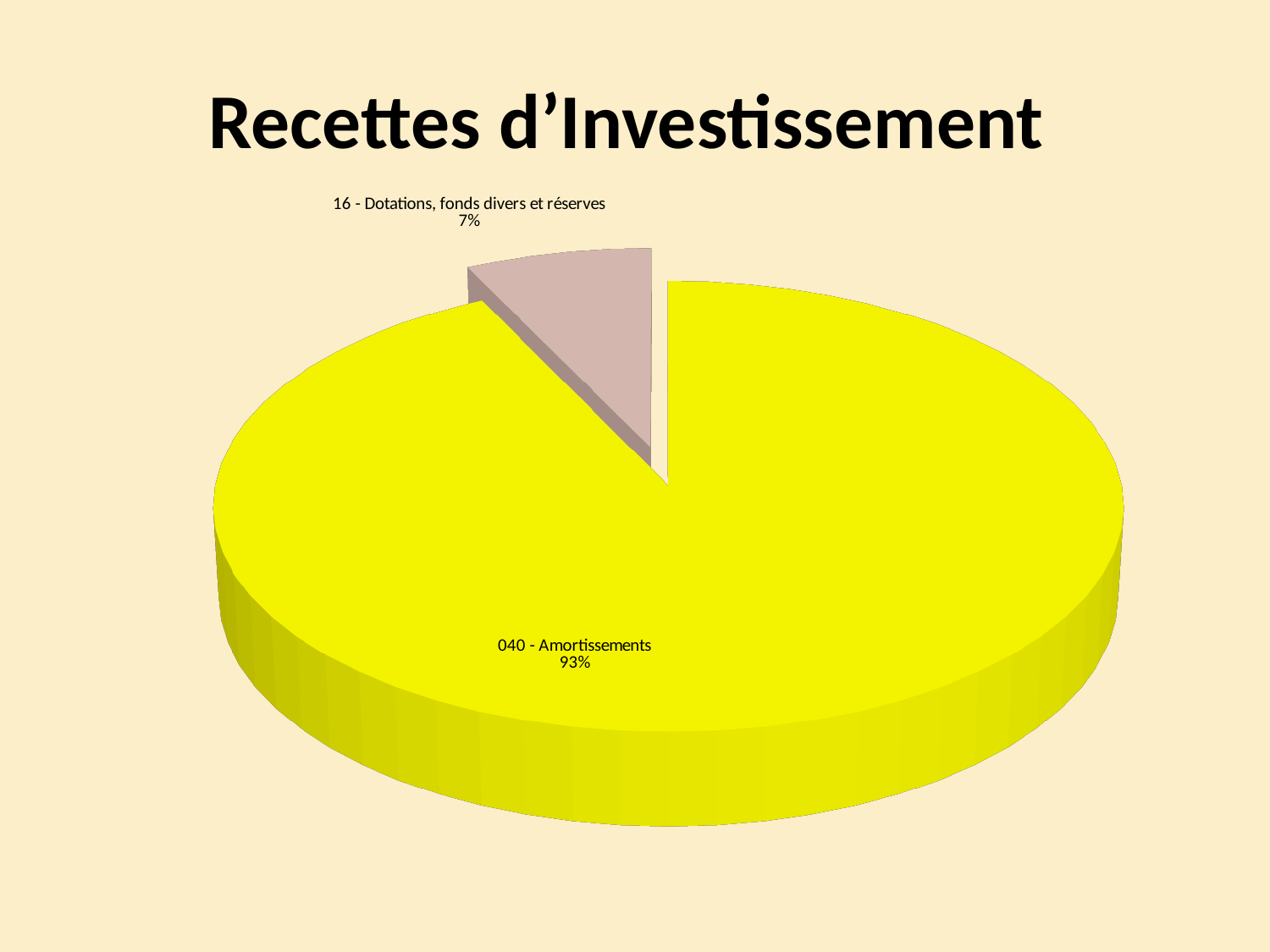
What colour is the "040 - Amortissements" slice? yellow What share of the pie does "16 - Dotations, fonds divers et réserves" represent? 7% What is the difference in percentage points between the "040 - Amortissements" slice and the "16 - Dotations, fonds divers et réserves" slice? 86 How many slices does the pie chart have? 2 What kind of chart is shown on the slide? pie chart Which slice is the smallest? 16 - Dotations, fonds divers et réserves What share of the pie does "040 - Amortissements" represent? 93% Which slice is the largest? 040 - Amortissements What is the title of the slide? Recettes d’Investissement Which is larger: the share for "040 - Amortissements" or the share for "16 - Dotations, fonds divers et réserves"? 040 - Amortissements